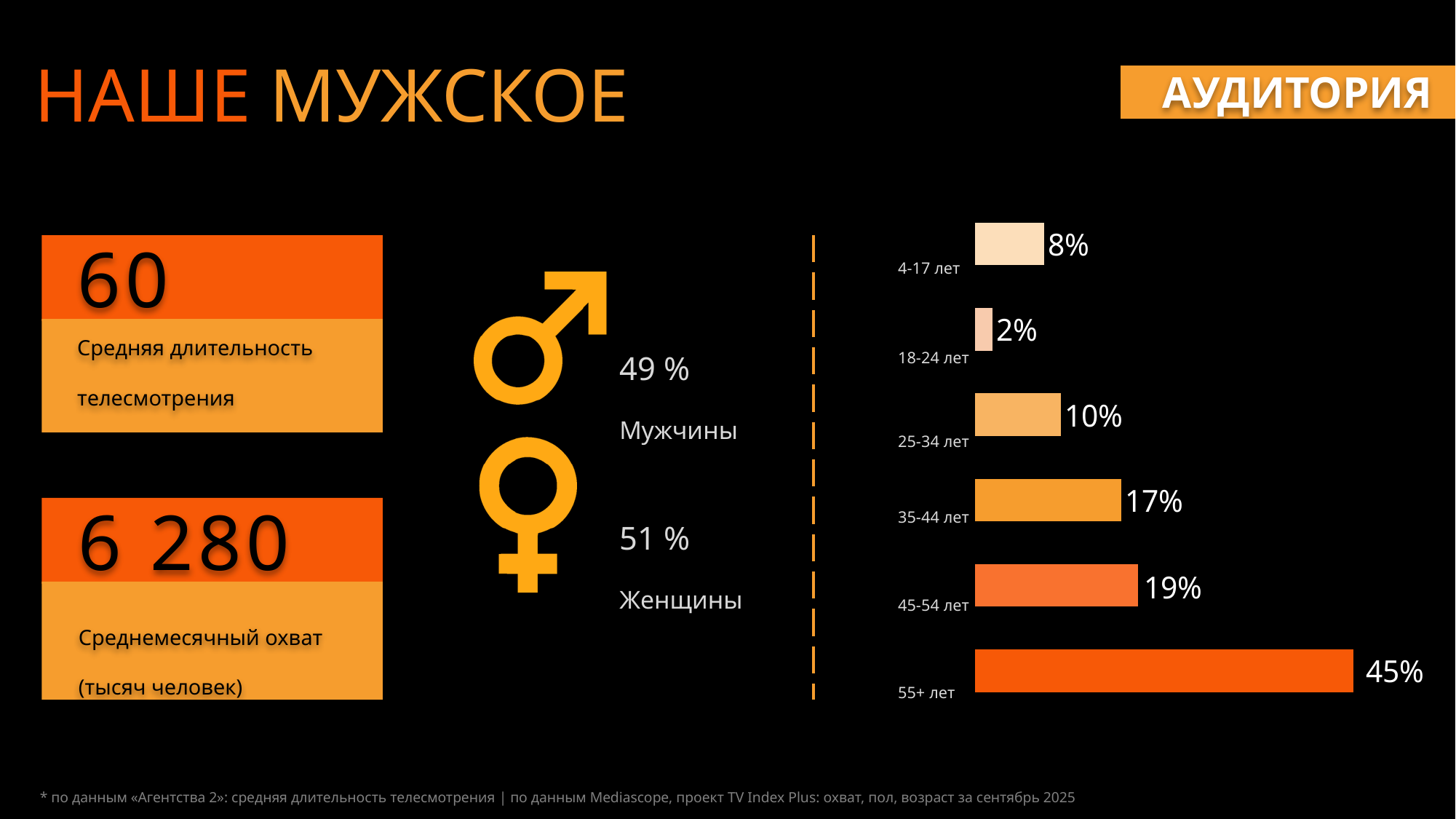
In the bar chart on the right, what is the value for the 18-24 лет age group? 2% In the bar chart on the right, which is larger: the value for 45-54 лет or the value for 35-44 лет? 45-54 лет What kind of chart is shown on the right side of the slide? Bar chart How many age groups are shown in the bar chart on the right? 6 In the bar chart on the right, what is the difference between the values for 25-34 лет and 4-17 лет? 2% In the bar chart on the right, what is the difference between the values for 55+ лет and 45-54 лет? 26% In the bar chart on the right, what is the value for the 55+ лет age group? 45% In the bar chart on the right, which age group has the highest value? 55+ лет In the bar chart on the right, do the values generally rise or fall as the age groups go from 25-34 лет to 55+ лет? Rise In the bar chart on the right, what is the value for the 35-44 лет age group? 17% In the bar chart on the right, what is the value for the 4-17 лет age group? 8% In the bar chart on the right, which age group has the lowest value? 18-24 лет